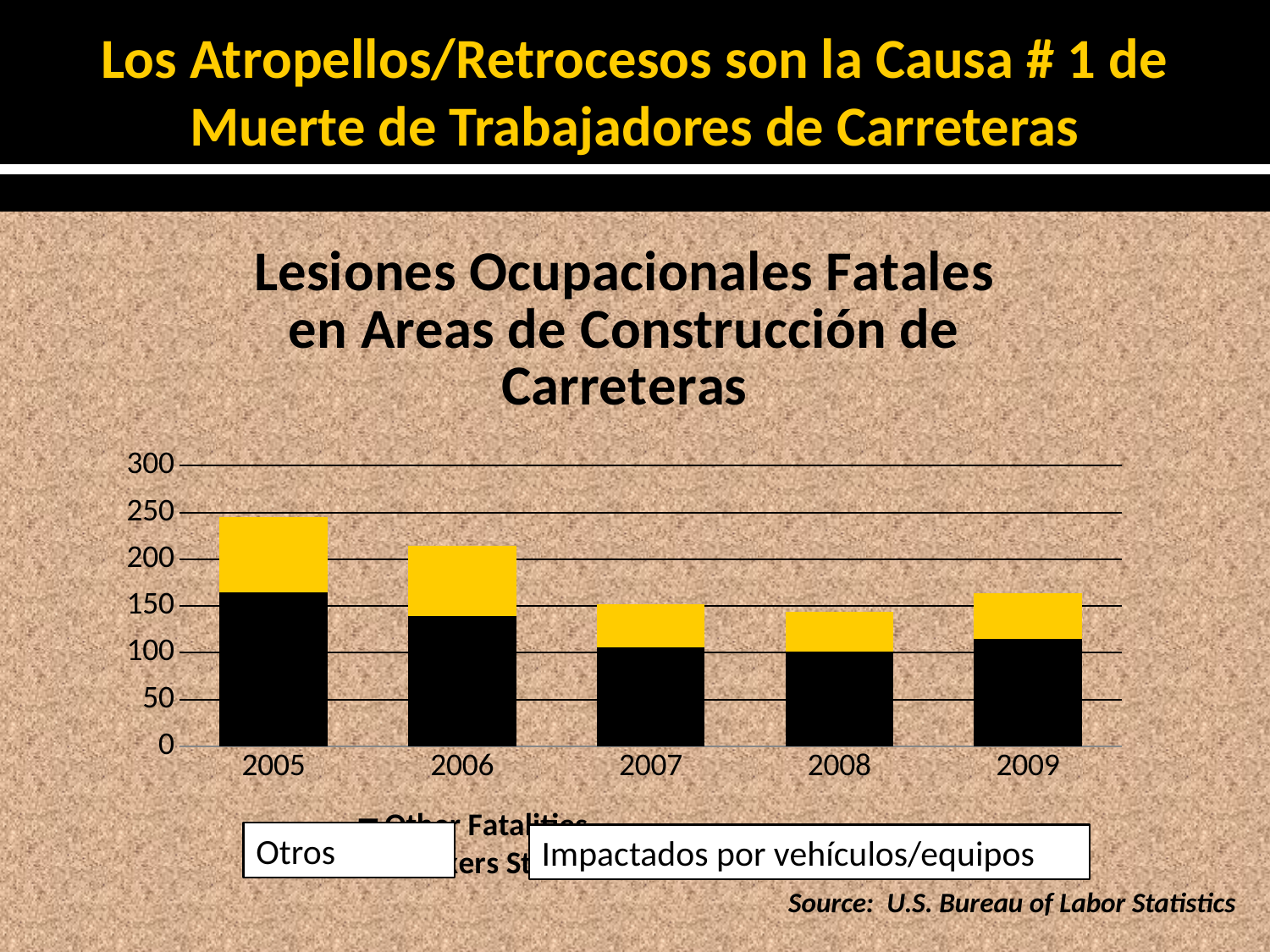
Is the total bar for 2005 greater or less than 200? greater Which year has a larger total bar, 2005 or 2006? 2005 Which year has the tallest total bar? 2005 Is the total bar for 2009 greater or less than 150? greater How many years are shown on the x axis of the chart? 5 Which year has the shortest total bar? 2008 What kind of chart is shown on the slide? Stacked bar chart Do the total bars rise or fall from 2005 to 2008? fall What is the title of the chart? Lesiones Ocupacionales Fatales en Areas de Construcción de Carreteras How many series are stacked in each bar of the chart? 2 Is the total bar for 2007 greater or less than 200? less